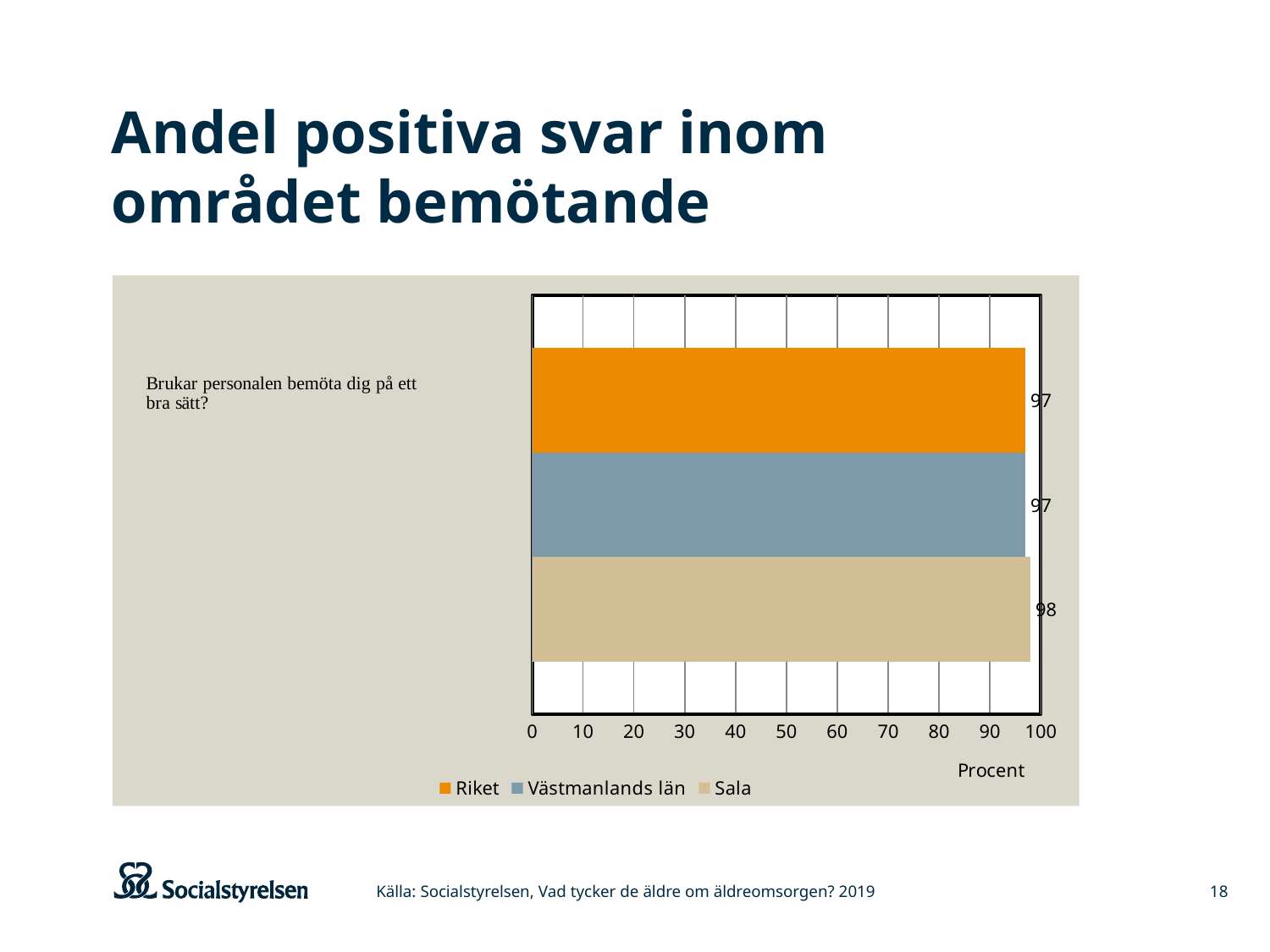
Which series has the highest value? Sala Which is larger, the value for Sala or the value for Västmanlands län? Sala What is the value for Riket? 97 What is the maximum value shown on the horizontal axis? 100 What is the value for Västmanlands län? 97 What kind of chart is shown on the slide? Bar chart What is the difference between the values for Sala and Riket? 1 What is the label on the horizontal axis? Procent How many series does the legend list? 3 What is the value for Sala? 98 Is the value for Riket greater or less than 90? greater What is the title of the slide? Andel positiva svar inom området bemötande